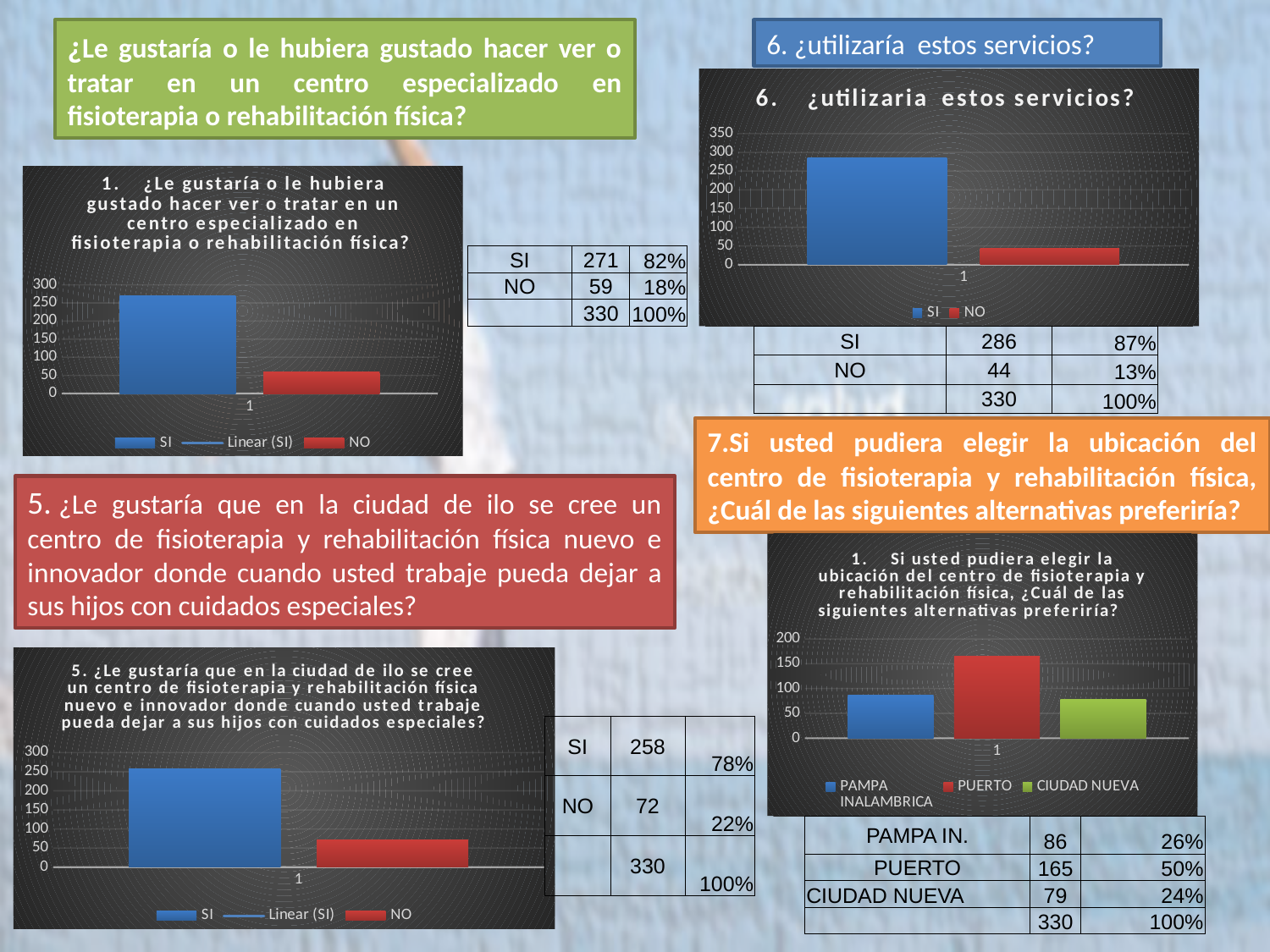
In the bottom-left chart '5. ¿Le gustaría que en la ciudad de ilo se cree un centro...', is the value for SI greater or less than 200? greater According to the table beside the bottom-right chart, what percentage does CIUDAD NUEVA represent? 24% In the bottom-right chart about choosing the location of the centre, which alternative has the highest bar? PUERTO In the top-right chart '6. ¿utilizaria estos servicios?', is the value for NO greater or less than 50? less In the bottom-right chart about choosing the location of the centre, which alternative has the lowest bar? CIUDAD NUEVA In the top-right chart '6. ¿utilizaria estos servicios?', which series has the taller bar, SI or NO? SI According to the table below the top-right chart '6. ¿utilizaria estos servicios?', what is the value for SI? 286 In the top-left chart about treatment in a specialised physiotherapy centre, how many entries does the legend list? 3 According to the table beside the bottom-right chart, what is the value for PUERTO? 165 What type of chart is the top-left chart about treatment in a specialised physiotherapy centre? bar chart In the bottom-right chart about choosing the location of the centre, is the value for PUERTO greater or less than 150? greater In the bottom-right chart about choosing the location of the centre, how many series does the legend list? 3